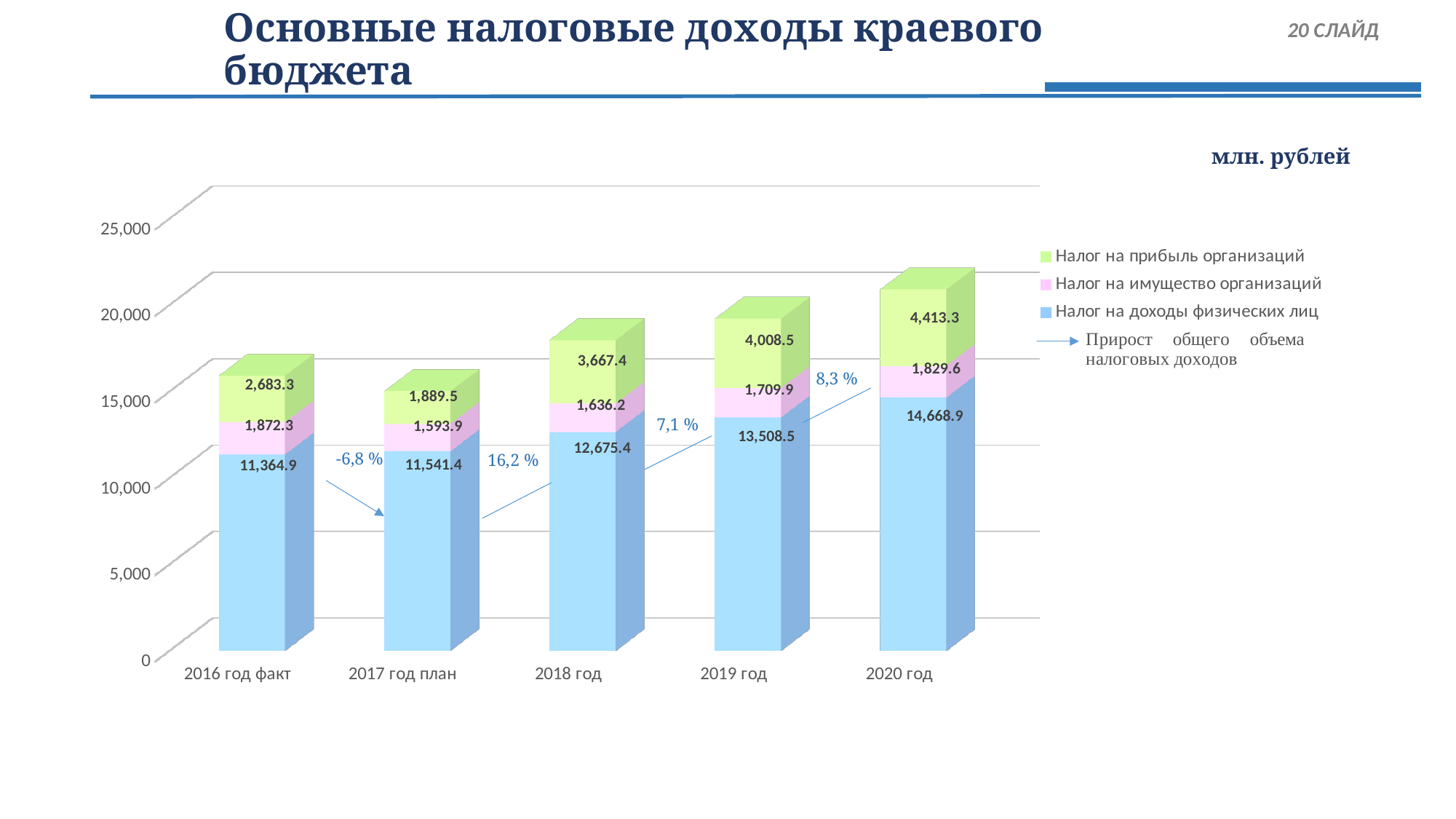
What is the value of Налог на имущество организаций for 2018 год? 1,636.2 What is the value of Налог на доходы физических лиц for 2016 год факт? 11,364.9 Which year has the lowest value for Налог на имущество организаций? 2017 год план What is the value of Налог на прибыль организаций for 2020 год? 4,413.3 What is the difference between Налог на доходы физических лиц in 2020 год and in 2016 год факт? 3,304.0 Which is larger: Налог на прибыль организаций in 2018 год or in 2019 год? 2019 год How many entries does the legend list? 4 How many year categories are shown on the x axis? 5 Which year has the highest value for Налог на прибыль организаций? 2020 год What kind of chart is shown on the slide? Stacked bar chart What percentage growth is labelled between 2017 год план and 2018 год? 16,2 % What is the total of the stacked bar for 2019 год? 19,226.9